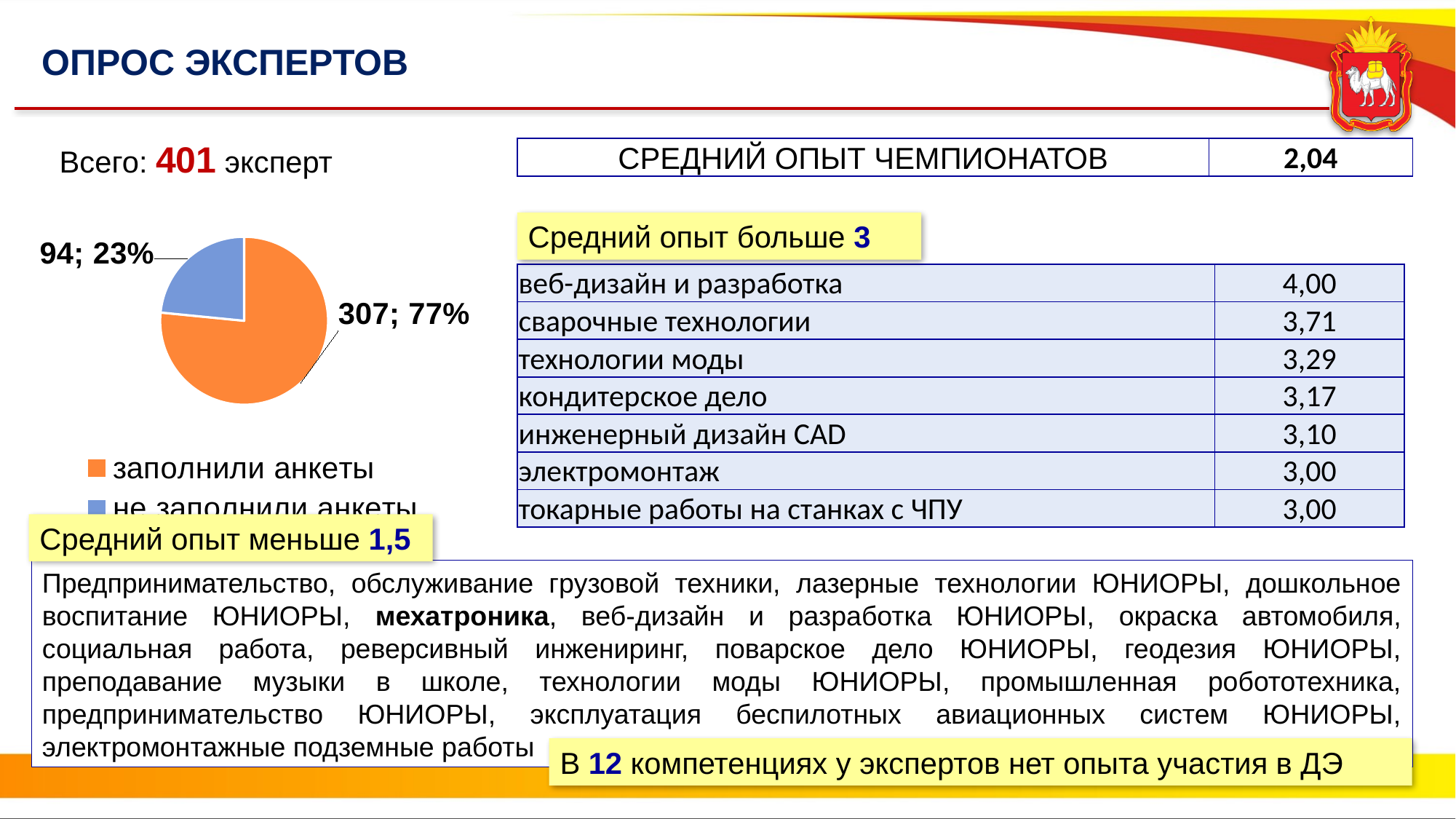
What colour is the "заполнили анкеты" slice in the pie chart? orange What share of the pie does "заполнили анкеты" represent? 77% Which slice of the pie chart is the smallest? не заполнили анкеты How many entries does the pie chart legend list? 2 How many slices does the pie chart have? 2 What kind of chart is shown on the slide? pie chart What is the value for "не заполнили анкеты" in the pie chart? 94 What is the difference between the values for "заполнили анкеты" and "не заполнили анкеты"? 213 Which is larger in the pie chart: "заполнили анкеты" or "не заполнили анкеты"? заполнили анкеты What is the value for "заполнили анкеты" in the pie chart? 307 Which slice of the pie chart is the largest? заполнили анкеты What share of the pie does "не заполнили анкеты" represent? 23%